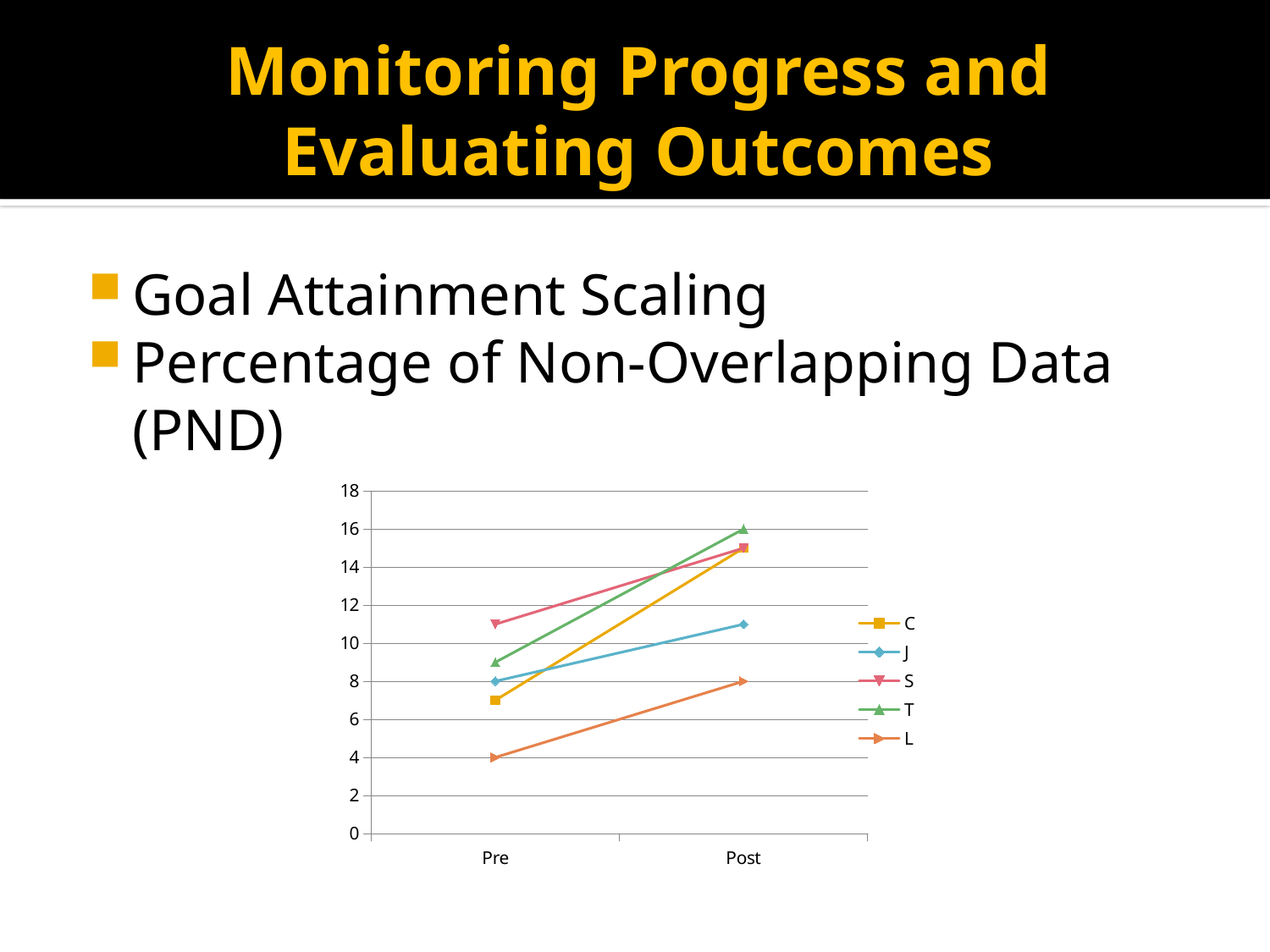
Is the value for C at Pre greater or less than 8? less By how much does the value for L increase from Pre to Post? 4 Is the value for S at Pre greater or less than 10? greater What kind of chart is shown on the slide? line chart What is the value for J at Pre? 8 What is the value for L at Pre? 4 What is the value for T at Post? 16 Which series has the highest value at Post? T How many categories are on the x axis? 2 Which series has the lowest value at Pre? L What is the value for L at Post? 8 How many series does the legend list? 5